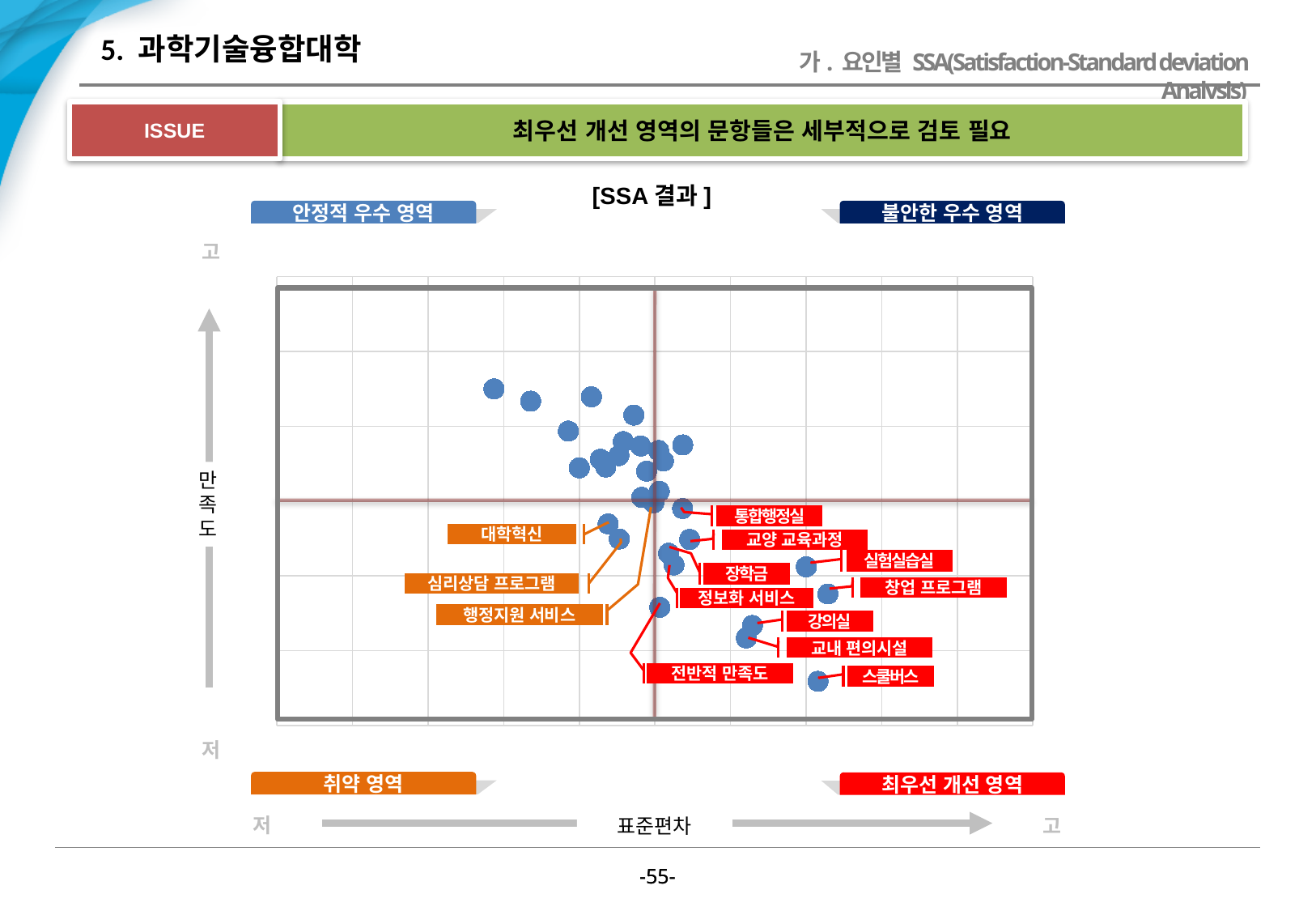
Which has a higher standard deviation (표준편차) on the chart, 창업 프로그램 or 대학혁신? 창업 프로그램 What is the label of the vertical axis of the chart? 만족도 What kind of chart is shown under the heading [SSA 결과]? scatter chart Which has higher satisfaction (만족도) on the chart, 대학혁신 or 교내 편의시설? 대학혁신 Which labelled point on the chart has the lowest satisfaction (만족도)? 스쿨버스 Which has higher satisfaction (만족도) on the chart, 통합행정실 or 스쿨버스? 통합행정실 What is the label of the horizontal axis of the chart? 표준편차 How many data points on the chart are labelled with a red label box? 10 How many data points on the chart are labelled with an orange label box? 3